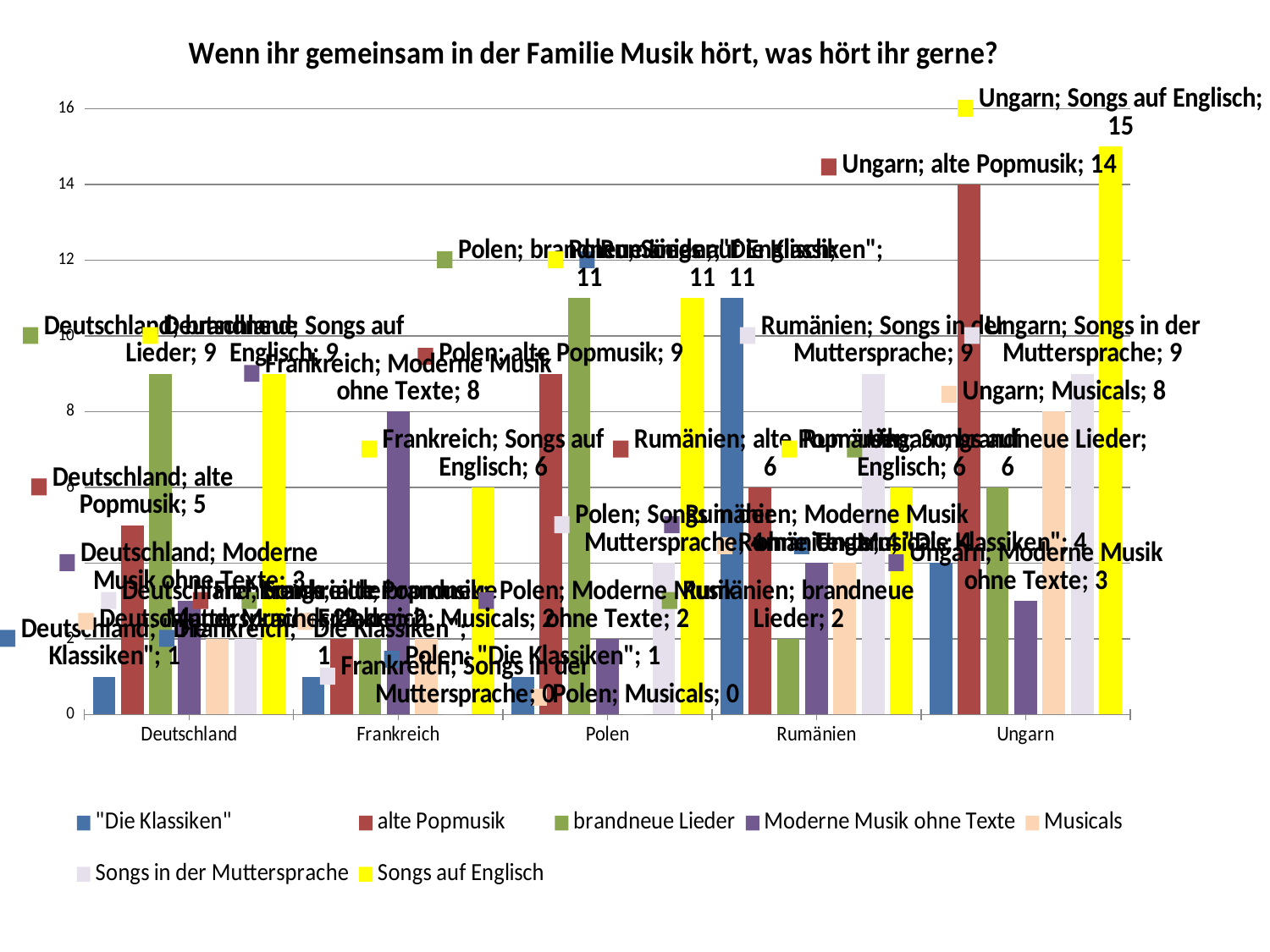
How many countries are shown along the x axis? 5 Which country has the highest bar for Songs auf Englisch? Ungarn What is the value for Moderne Musik ohne Texte in Frankreich? 8 What kind of chart is shown on the slide? bar chart What is the title of the chart? Wenn ihr gemeinsam in der Familie Musik hört, was hört ihr gerne? What is the value for alte Popmusik in Ungarn? 14 Which is larger in Ungarn: Musicals or Moderne Musik ohne Texte? Musicals What is the value for Musicals in Ungarn? 8 What is the value for Songs auf Englisch in Ungarn? 15 How many series does the legend list? 7 What is the difference between Songs auf Englisch and alte Popmusik in Ungarn? 1 What is the value for alte Popmusik in Deutschland? 5